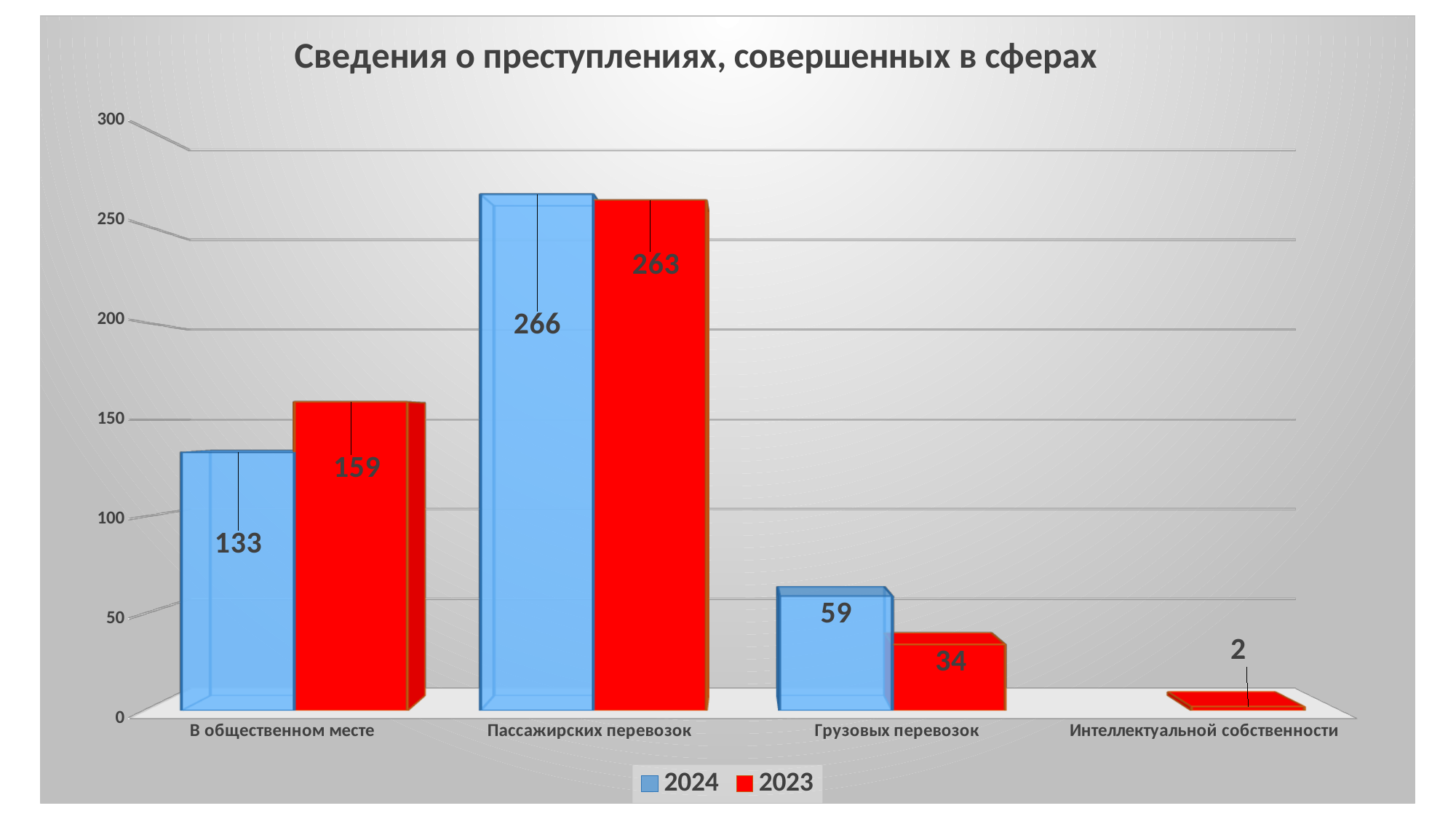
Which is larger for «В общественном месте»: the 2024 value or the 2023 value? 2023 What kind of chart is shown on the slide? Bar chart What is the difference between the 2023 and 2024 values for «В общественном месте»? 26 What is the value for 2023 in the category «Грузовых перевозок»? 34 What is the title of the chart? Сведения о преступлениях, совершенных в сферах Which category has the highest value for the 2024 series? Пассажирских перевозок What is the difference between the 2024 and 2023 values for «Грузовых перевозок»? 25 Which category has the lowest value for the 2023 series? Интеллектуальной собственности What is the value for 2024 in the category «В общественном месте»? 133 How many series does the legend list? 2 What is the value for 2023 in the category «Пассажирских перевозок»? 263 What is the value for 2023 in the category «Интеллектуальной собственности»? 2